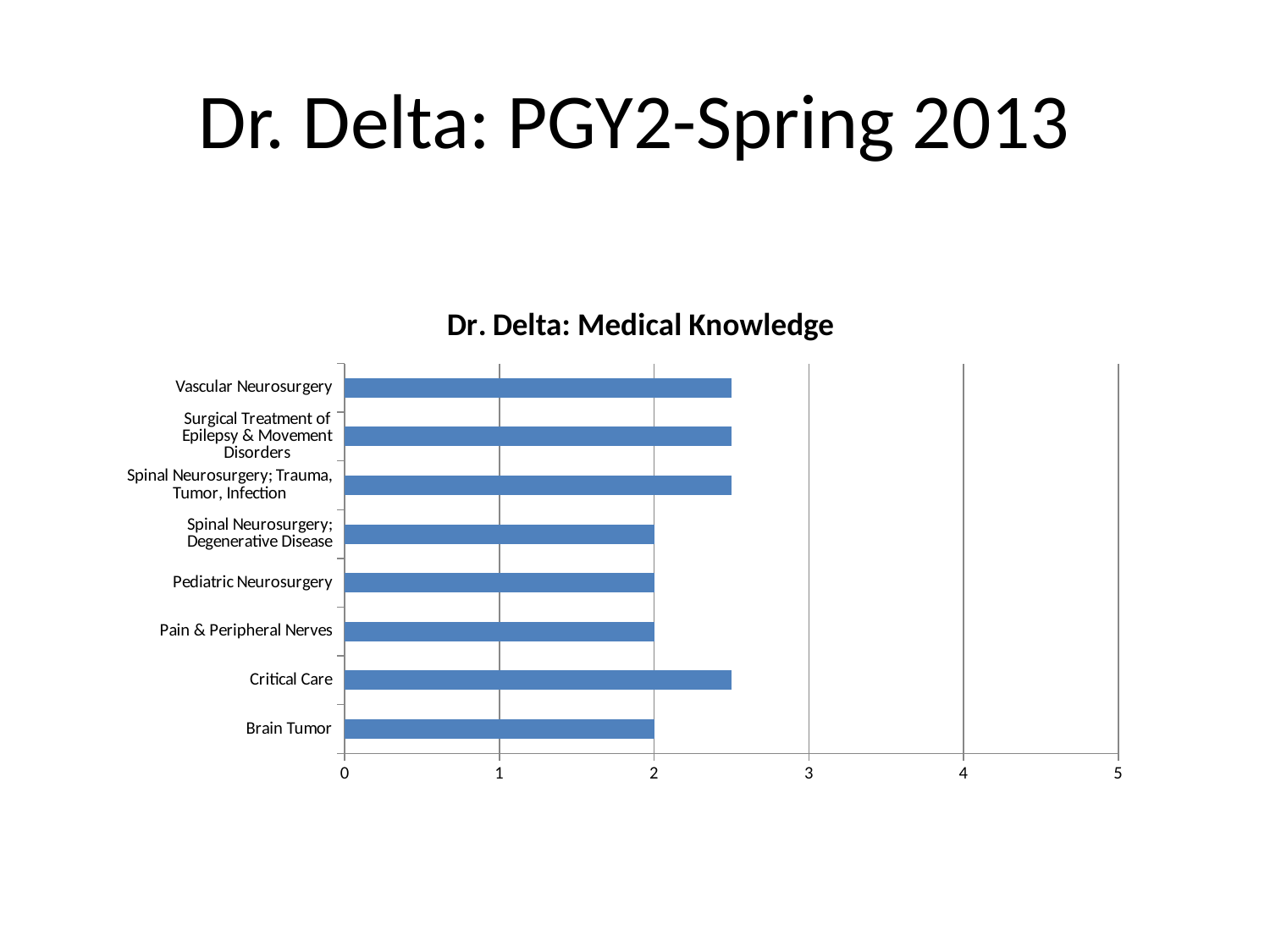
What type of chart is shown on the slide? bar chart Is the value for Surgical Treatment of Epilepsy & Movement Disorders greater or less than 2? greater Which is larger, the value for Critical Care or the value for Brain Tumor? Critical Care What is the value for Pediatric Neurosurgery? 2 Is the value for Vascular Neurosurgery greater or less than 3? less What is the title of the chart? Dr. Delta: Medical Knowledge What is the value for Brain Tumor? 2 What is the value for Pain & Peripheral Nerves? 2 What is the value for Spinal Neurosurgery; Degenerative Disease? 2 Is the value for Critical Care greater or less than 2? greater What is the maximum value shown on the horizontal axis? 5 How many categories are plotted in the chart? 8